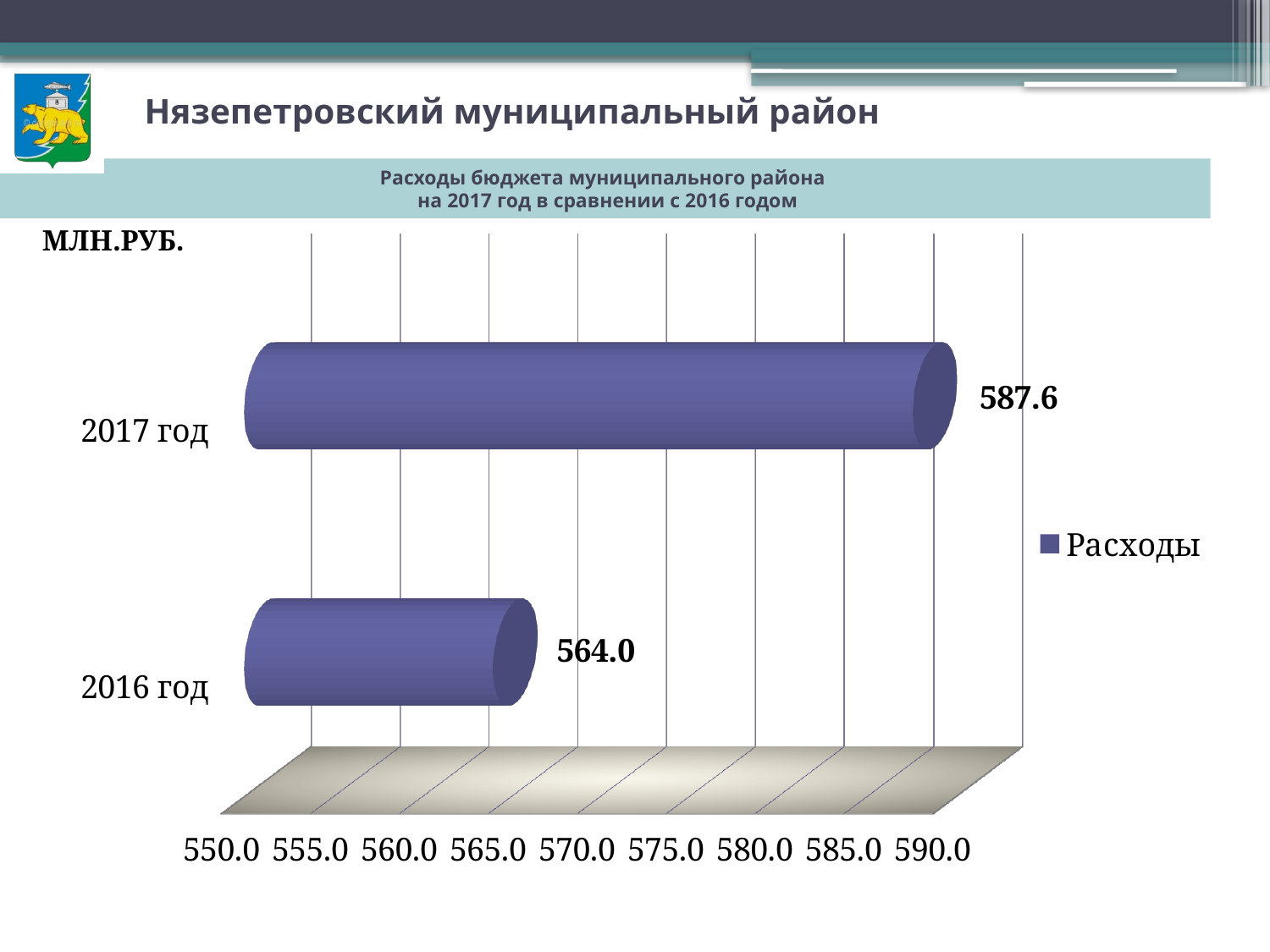
What is the name of the series shown in the legend? Расходы Is the value for 2017 год larger or smaller than the value for 2016 год? larger What kind of chart is shown on the slide? bar chart What is the difference between the values for 2017 год and 2016 год? 23.6 How many categories are shown on the chart? 2 Which year has the higher expenditure value? 2017 год Which year has the lower expenditure value? 2016 год What is the value for 2017 год? 587.6 Is the value for 2016 год greater or less than 570.0? less What is the value for 2016 год? 564.0 How many series does the legend list? 1 Is the value for 2017 год greater or less than 580.0? greater